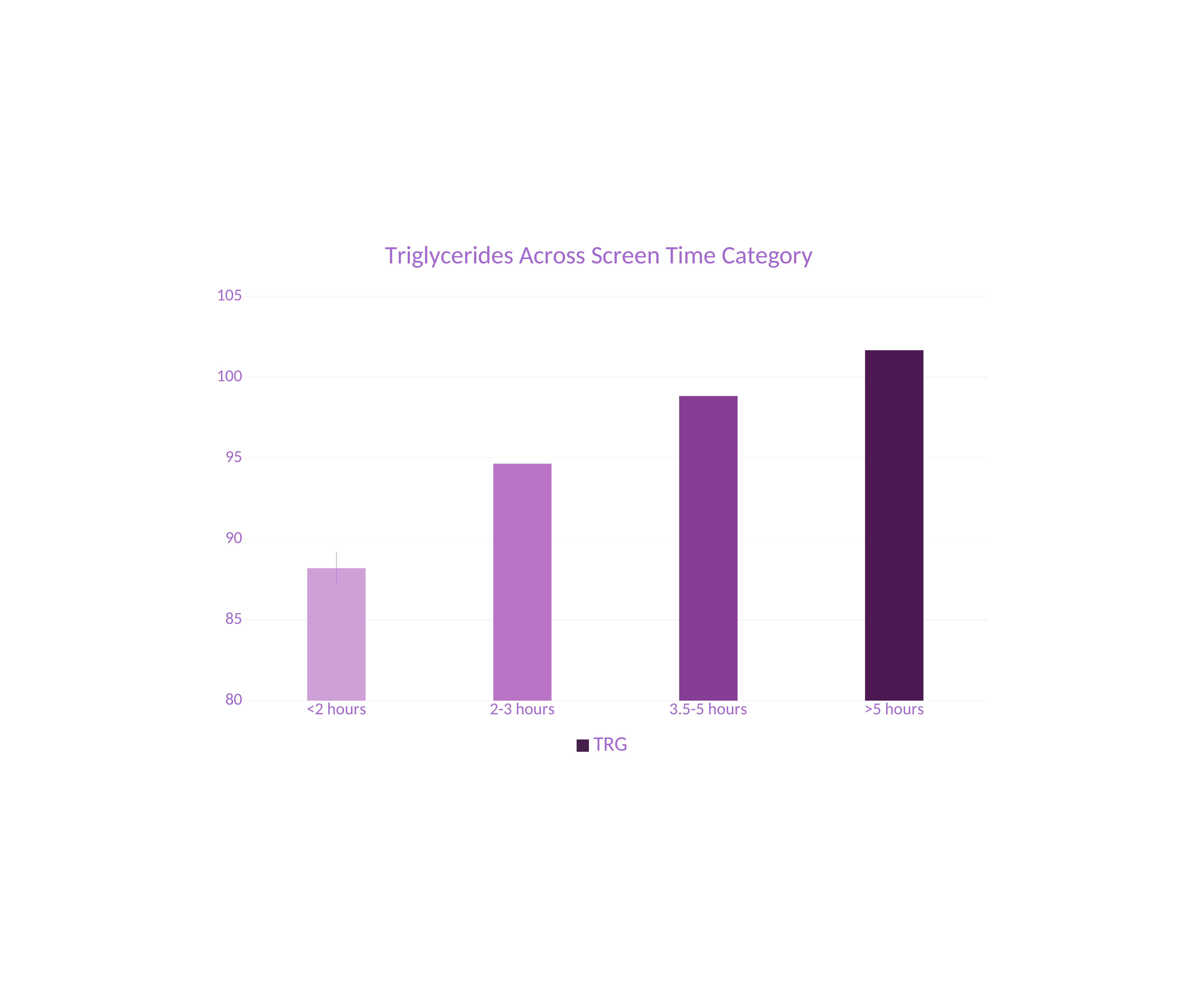
Do the TRG values rise or fall as screen time increases along the x axis? rise Is the TRG value for <2 hours greater or less than 90? less Is the TRG value for 2-3 hours greater or less than 90? greater What kind of chart is shown on the slide? bar chart How many series does the legend list? 1 Which screen time category has the lowest TRG value? <2 hours What is the name of the series shown in the legend? TRG What is the title of the chart? Triglycerides Across Screen Time Category Which has a larger TRG value, 2-3 hours or 3.5-5 hours? 3.5-5 hours Which screen time category has the highest TRG value? >5 hours Is the TRG value for >5 hours greater or less than 100? greater How many screen time categories are shown on the x axis? 4